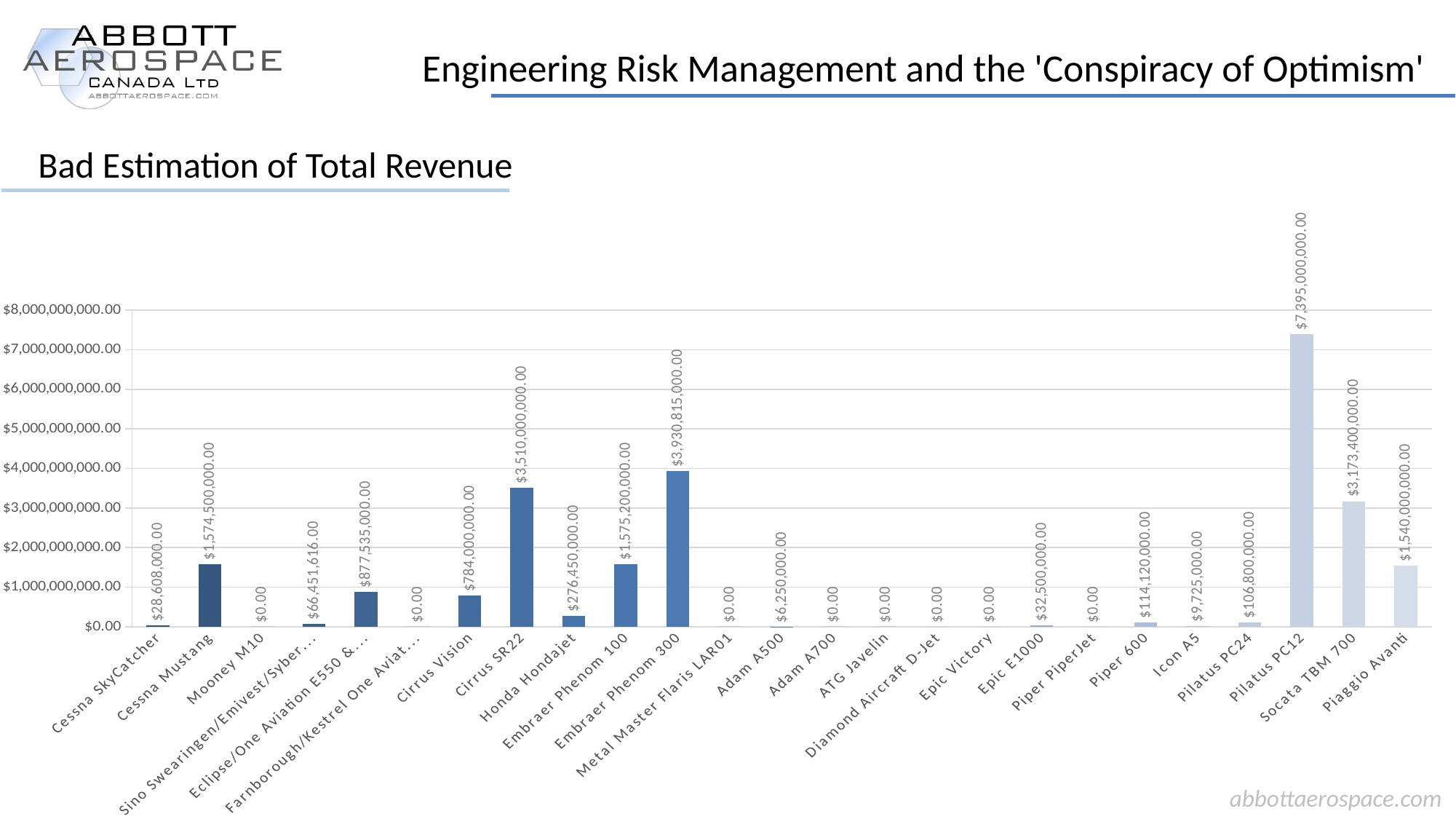
Which is larger, the value for Cirrus SR22 or the value for Socata TBM 700? Cirrus SR22 Is the value for Pilatus PC12 greater or less than $7,000,000,000.00? greater What kind of chart is shown on the slide? bar chart What is the title of the chart? Bad Estimation of Total Revenue What is the value for Pilatus PC12? $7,395,000,000.00 What is the value for Honda Hondajet? $276,450,000.00 What is the value for Cirrus Vision? $784,000,000.00 How many categories are shown on the x axis? 25 Which category has the highest value? Pilatus PC12 What is the difference between the values for Cirrus SR22 and Socata TBM 700? $336,600,000.00 What is the value for Embraer Phenom 300? $3,930,815,000.00 What is the difference between the values for Pilatus PC12 and Embraer Phenom 300? $3,464,185,000.00